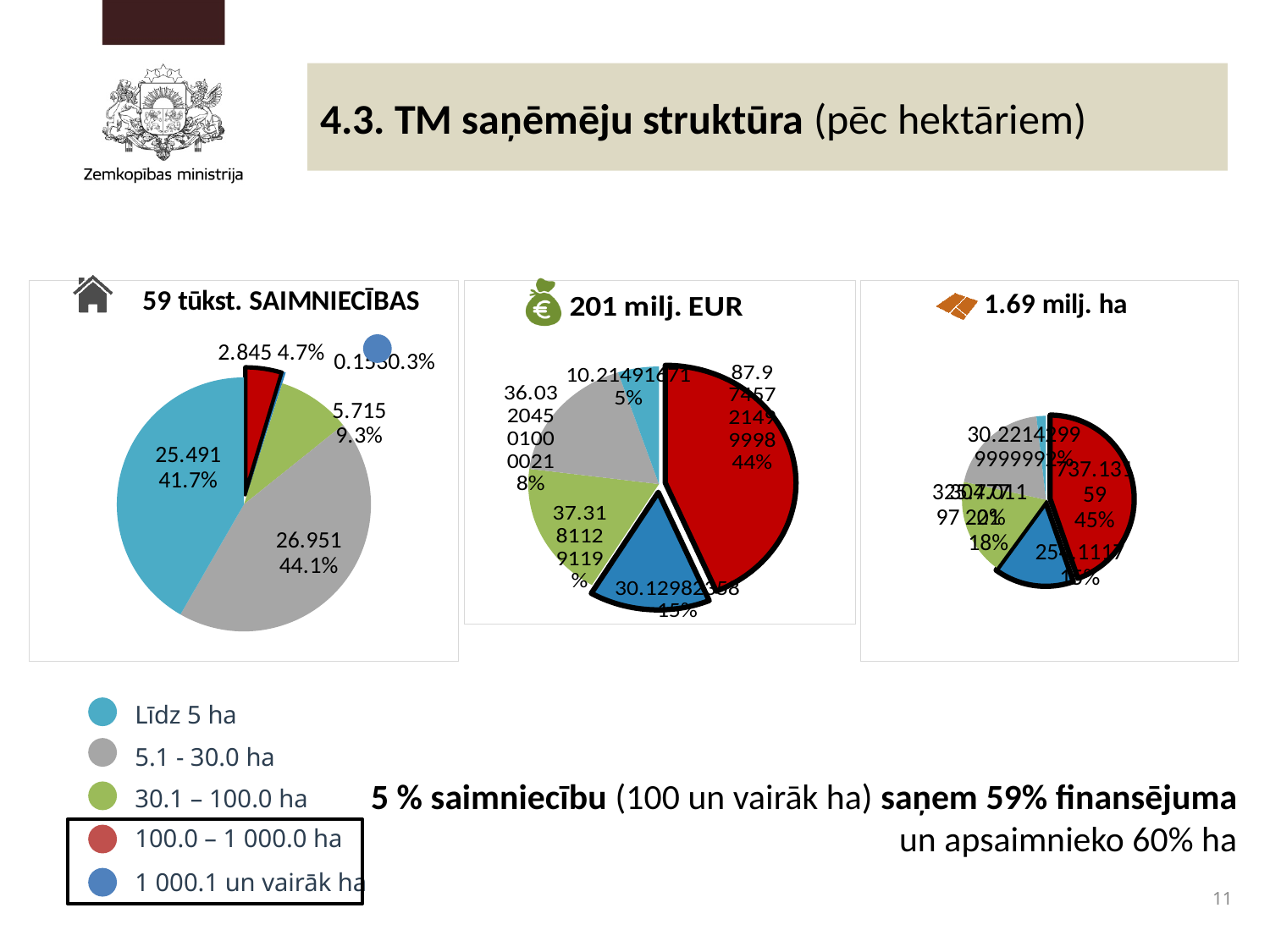
In the '59 tūkst. SAIMNIECĪBAS' pie chart, which category has the largest slice? 5.1 - 30.0 ha What kind of chart is used in the '59 tūkst. SAIMNIECĪBAS' panel? pie chart In the '201 milj. EUR' pie chart, what share is shown for the '100.0 – 1 000.0 ha' slice? 44% In the '1.69 milj. ha' pie chart, what share is shown for the '100.0 – 1 000.0 ha' slice? 45% In the '59 tūkst. SAIMNIECĪBAS' pie chart, which category has the smallest slice? 1 000.1 un vairāk ha In the '201 milj. EUR' pie chart, what share is shown for the '1 000.1 un vairāk ha' slice? 15% In the '59 tūkst. SAIMNIECĪBAS' pie chart, what value is printed for the '5.1 - 30.0 ha' slice? 26.951 In the '59 tūkst. SAIMNIECĪBAS' pie chart, what is the difference in percentage points between the '5.1 - 30.0 ha' and 'Līdz 5 ha' shares? 2.4 In the '59 tūkst. SAIMNIECĪBAS' pie chart, what value is printed for the '100.0 – 1 000.0 ha' slice? 2.845 How many categories does the legend list for the pie charts? 5